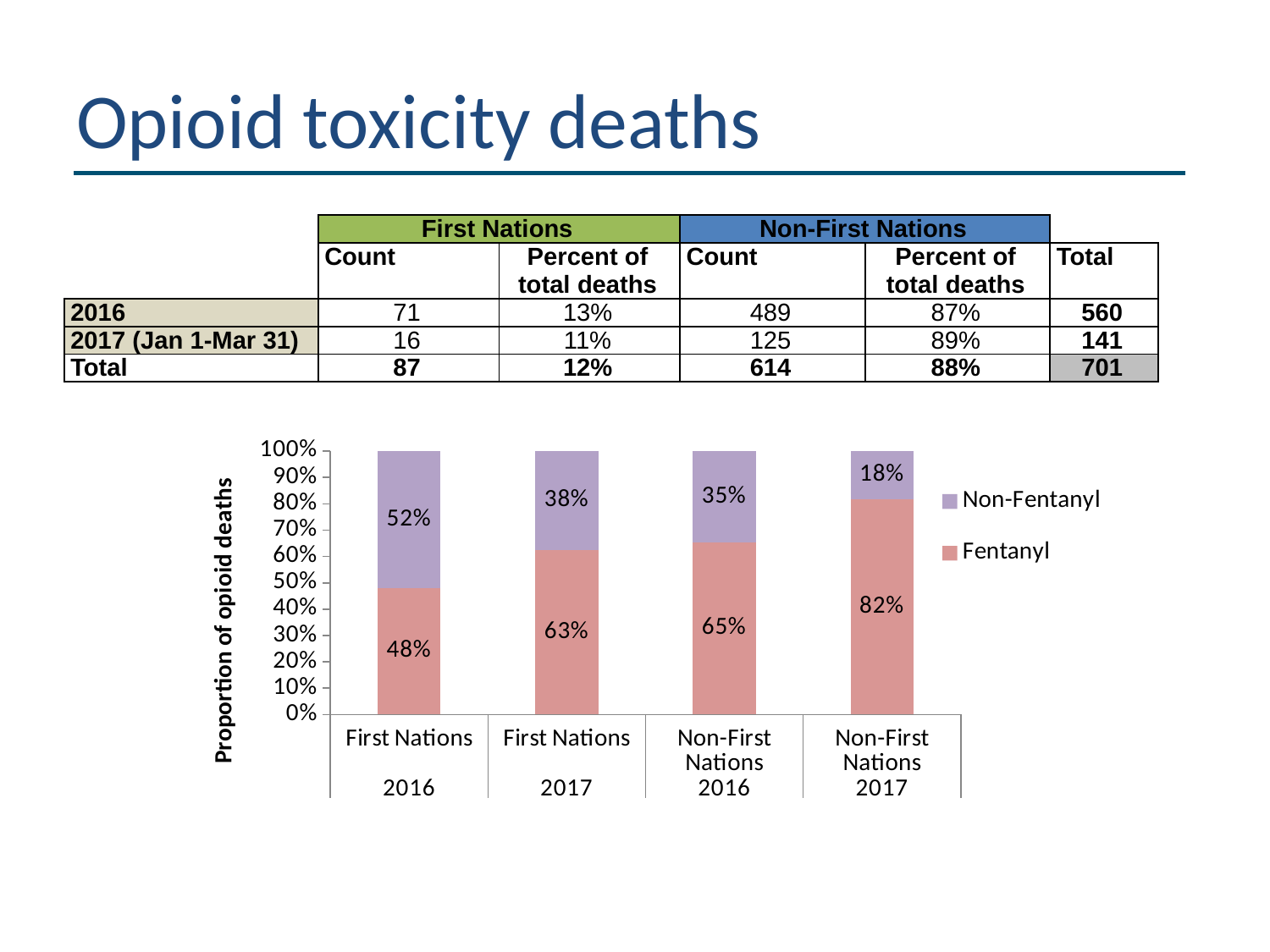
Which is larger: the Fentanyl proportion for First Nations in 2017 or for Non-First Nations in 2016? Non-First Nations 2016 What is the Fentanyl proportion for Non-First Nations in 2016? 65% What is the difference between the Fentanyl proportion for Non-First Nations in 2017 and for First Nations in 2016? 34% Which bar has the highest Fentanyl proportion? Non-First Nations 2017 Which bar has the lowest Non-Fentanyl proportion? Non-First Nations 2017 What is the Fentanyl proportion for First Nations in 2016? 48% How many bars are plotted in the chart? 4 How many series does the chart legend list? 2 What type of chart is shown on the slide? stacked bar chart What is the Non-Fentanyl proportion for Non-First Nations in 2017? 18% What is the Non-Fentanyl proportion for First Nations in 2017? 38% What is the label of the chart's vertical axis? Proportion of opioid deaths